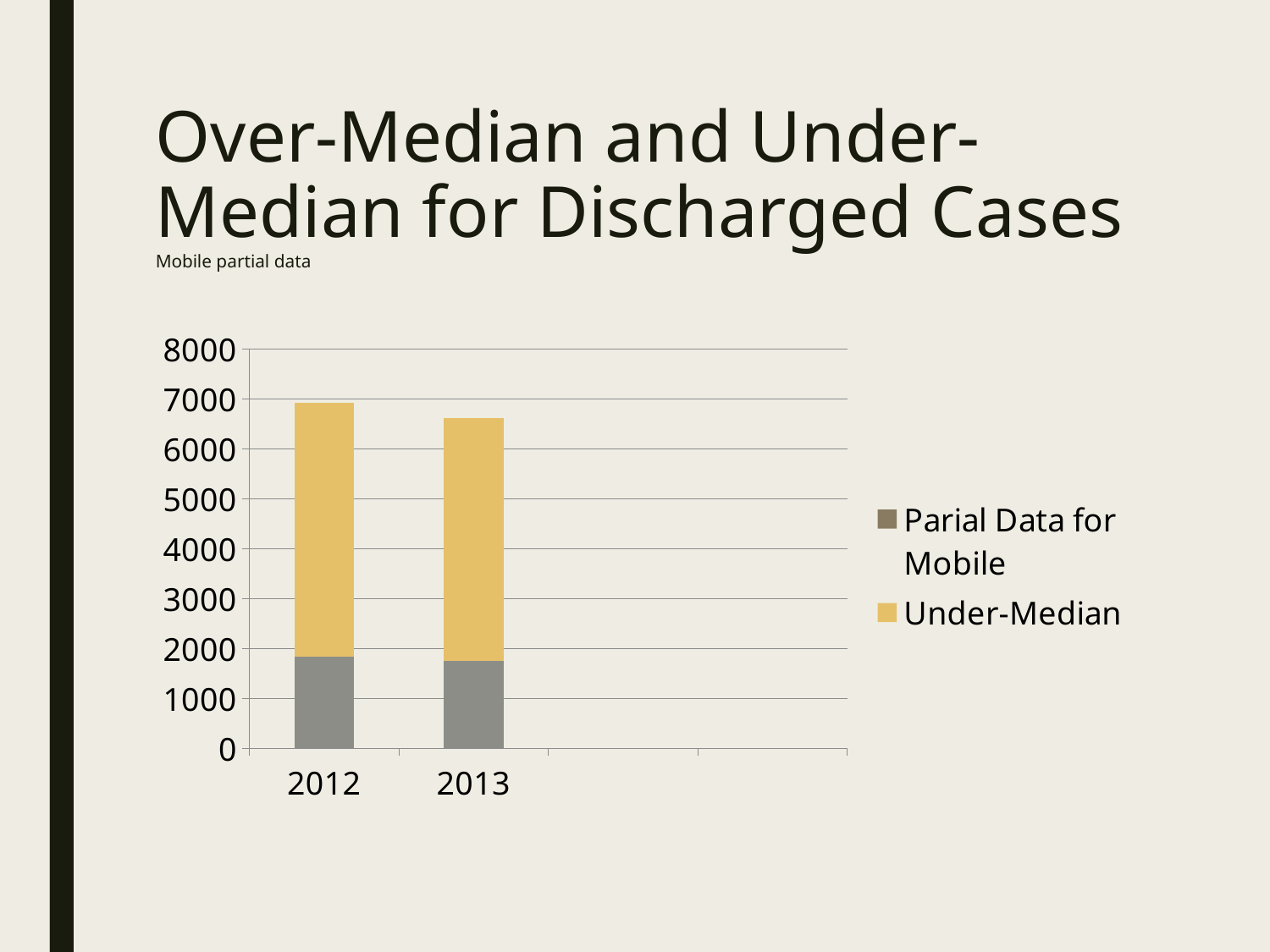
Is the total height of the 2012 bar greater or less than 6000? greater Is the Under-Median segment for 2013 greater or less than 4000? greater Which year has the taller stacked bar, 2012 or 2013? 2012 How many categories are shown on the x axis? 2 How many series does the legend list? 2 Is the total height of the 2013 bar greater or less than 7000? less What kind of chart is shown on the slide? Stacked bar chart Do the total bar heights rise or fall from 2012 to 2013? fall Which years are shown on the x axis? 2012 and 2013 Which series is shown in yellow? Under-Median